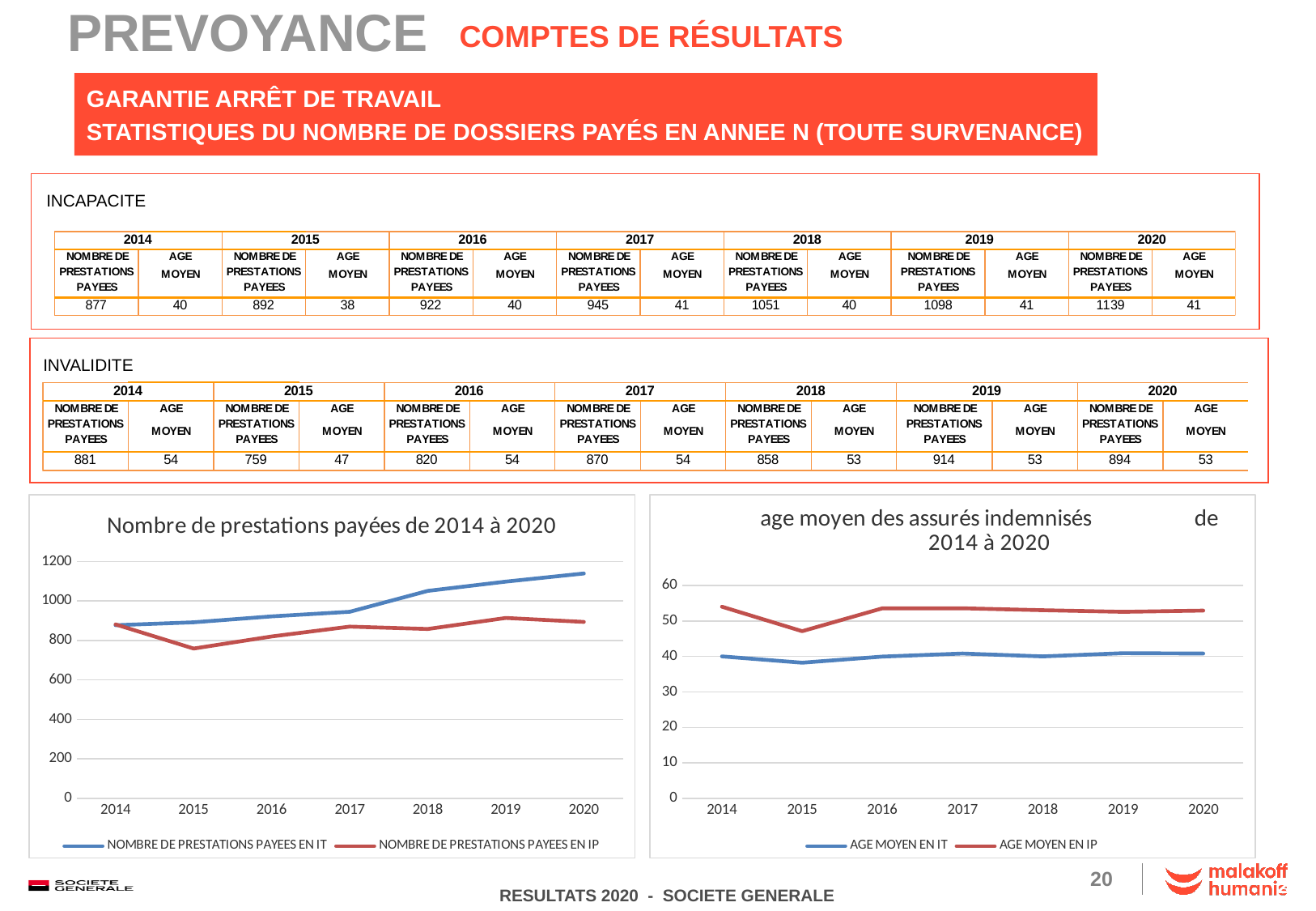
In the chart "Nombre de prestations payées de 2014 à 2020", in which year is NOMBRE DE PRESTATIONS PAYEES EN IP lowest? 2015 What are the two legend entries of the chart "age moyen des assurés indemnisés de 2014 à 2020"? AGE MOYEN EN IT and AGE MOYEN EN IP In the chart "age moyen des assurés indemnisés de 2014 à 2020", which series is higher in 2016, AGE MOYEN EN IT or AGE MOYEN EN IP? AGE MOYEN EN IP In the chart "age moyen des assurés indemnisés de 2014 à 2020", is the value for AGE MOYEN EN IT in 2014 greater or less than 50? less In the chart "Nombre de prestations payées de 2014 à 2020", is the value for NOMBRE DE PRESTATIONS PAYEES EN IP in 2015 greater or less than 800? less In the chart "Nombre de prestations payées de 2014 à 2020", does the series NOMBRE DE PRESTATIONS PAYEES EN IT rise or fall from 2014 to 2020? rise How many years are shown on the x axis of the chart "Nombre de prestations payées de 2014 à 2020"? 7 What kind of chart is the chart titled "Nombre de prestations payées de 2014 à 2020"? line chart In the chart "age moyen des assurés indemnisés de 2014 à 2020", in which year is AGE MOYEN EN IP lowest? 2015 In the chart "Nombre de prestations payées de 2014 à 2020", is the value for NOMBRE DE PRESTATIONS PAYEES EN IT in 2020 greater or less than 1000? greater How many series does the legend of the chart "Nombre de prestations payées de 2014 à 2020" list? 2 In the chart "Nombre de prestations payées de 2014 à 2020", in which year is NOMBRE DE PRESTATIONS PAYEES EN IT highest? 2020